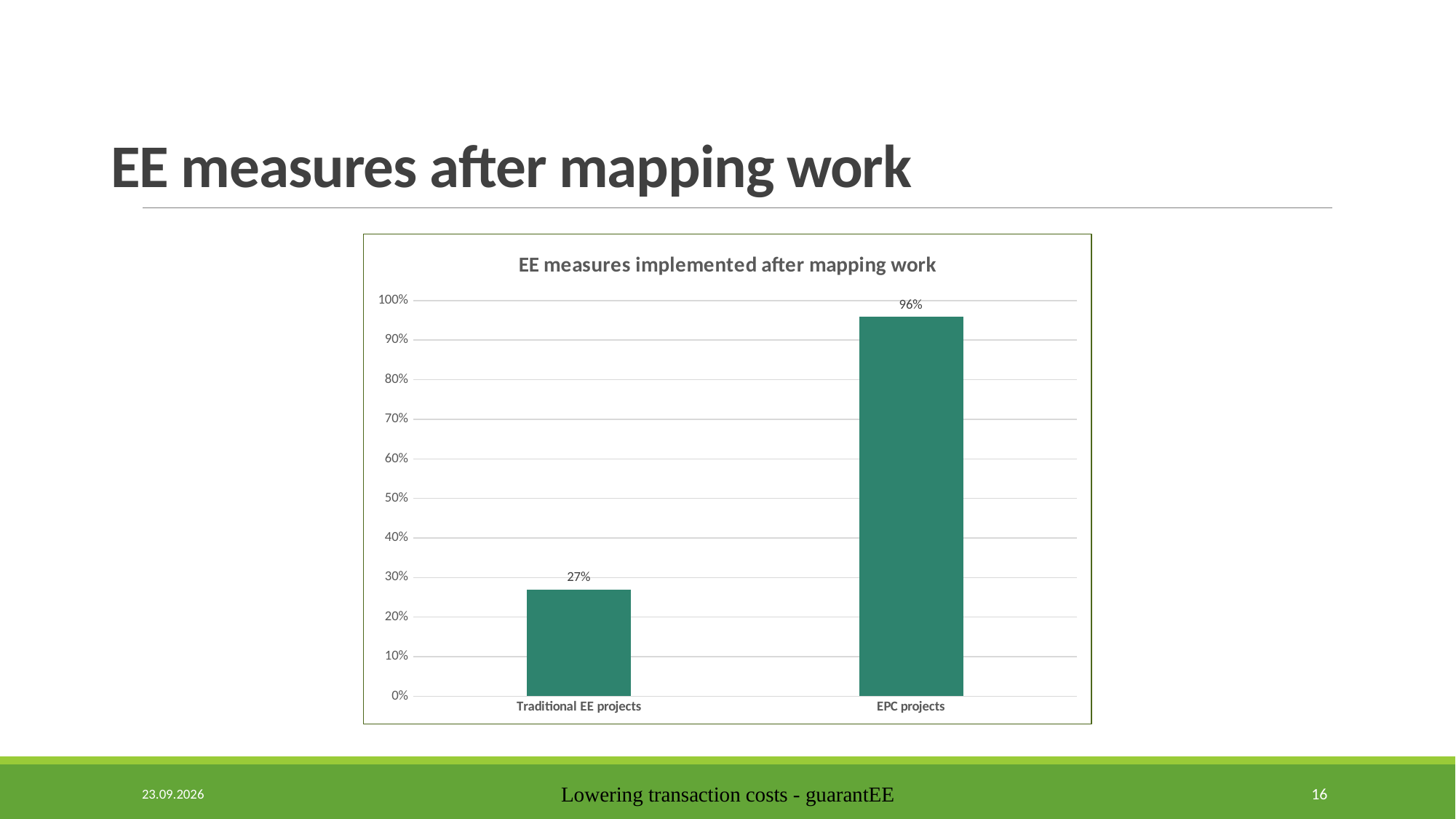
Is the value for EPC projects greater or less than 90%? greater Is the value for Traditional EE projects greater or less than 30%? less What is the difference in percentage points between EPC projects and Traditional EE projects? 69 percentage points What is the title of the chart? EE measures implemented after mapping work What is the highest value shown on the y axis of the chart? 100% What kind of chart is shown on the slide? Bar chart Which is larger: the value for Traditional EE projects or the value for EPC projects? EPC projects Which category has the highest value in the chart? EPC projects How many categories are shown on the x axis of the chart? 2 Which category has the lowest value in the chart? Traditional EE projects What percentage of EE measures were implemented after mapping work for EPC projects? 96% What percentage of EE measures were implemented after mapping work for Traditional EE projects? 27%